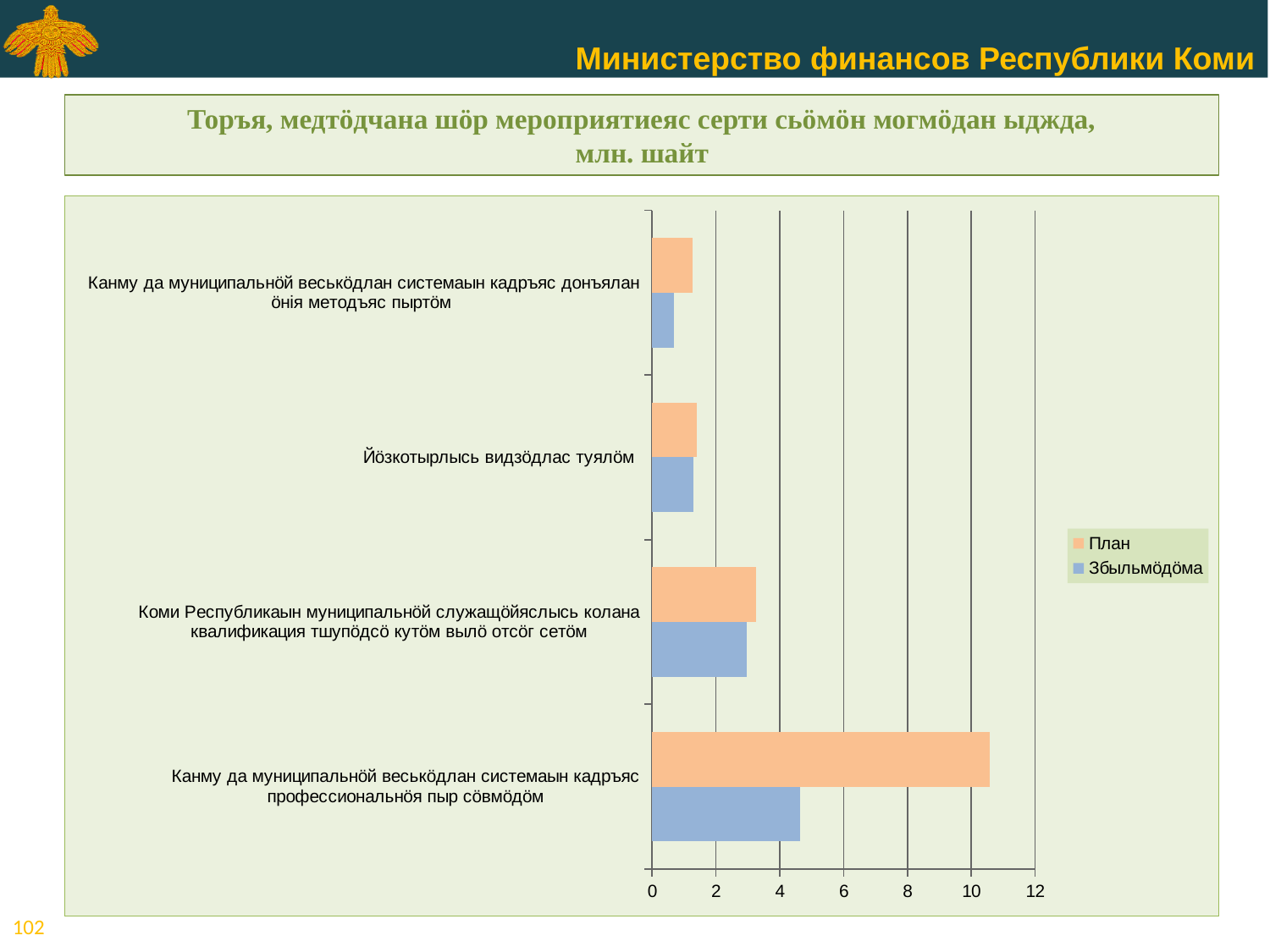
What kind of chart is shown on the slide? bar chart Is the План value for 'Канму да муниципальнӧй веськӧдлан системаын кадръяс профессиональнӧя пыр сӧвмӧдӧм' greater or less than 10? greater Which category has the highest План value? Канму да муниципальнӧй веськӧдлан системаын кадръяс профессиональнӧя пыр сӧвмӧдӧм Which category has the lowest Збыльмӧдӧма value? Канму да муниципальнӧй веськӧдлан системаын кадръяс донъялан ӧнія методъяс пыртӧм What is the unit of measurement stated in the chart title? млн. шайт Is the Збыльмӧдӧма value for 'Канму да муниципальнӧй веськӧдлан системаын кадръяс донъялан ӧнія методъяс пыртӧм' greater or less than 2? less Is the Збыльмӧдӧма value for 'Канму да муниципальнӧй веськӧдлан системаын кадръяс профессиональнӧя пыр сӧвмӧдӧм' greater or less than 6? less What are the two series named in the legend? План and Збыльмӧдӧма How many categories are plotted on the chart? 4 For 'Канму да муниципальнӧй веськӧдлан системаын кадръяс профессиональнӧя пыр сӧвмӧдӧм', which is larger: План or Збыльмӧдӧма? План How many series does the legend list? 2